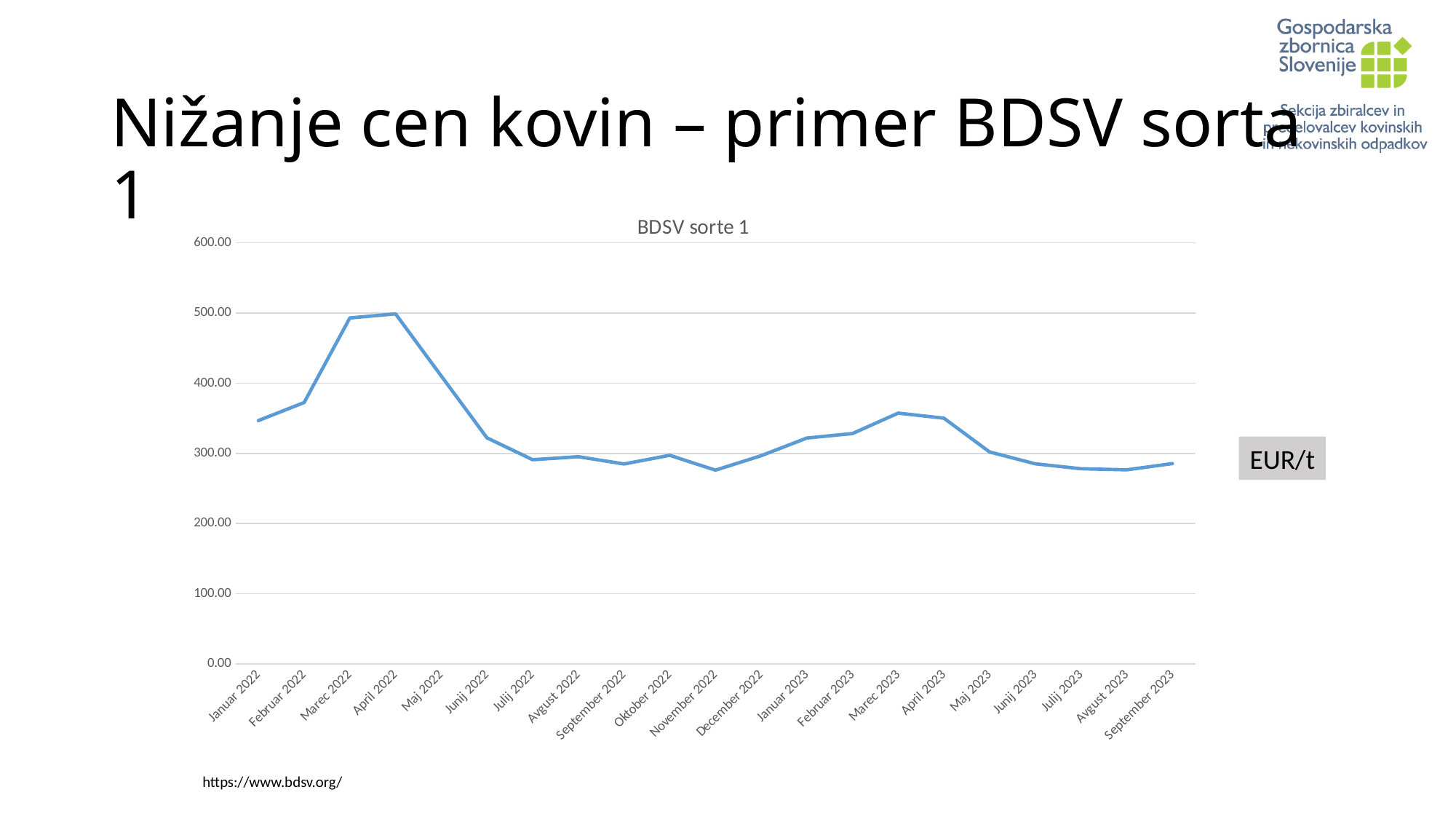
Is the value for November 2022 greater or less than 300? less Is the value for Januar 2022 greater or less than 400? less Is the value for Marec 2022 greater or less than 400? greater What unit is indicated next to the chart? EUR/t What is the title of the chart? BDSV sorte 1 What kind of chart is shown on the slide? line chart Do the values rise or fall from April 2022 to Julij 2022? fall Which month has the highest value on the chart? April 2022 Do the values rise or fall from Januar 2022 to April 2022? rise Which is larger, the value for Marec 2022 or the value for Marec 2023? Marec 2022 How many monthly data points are plotted on the chart? 21